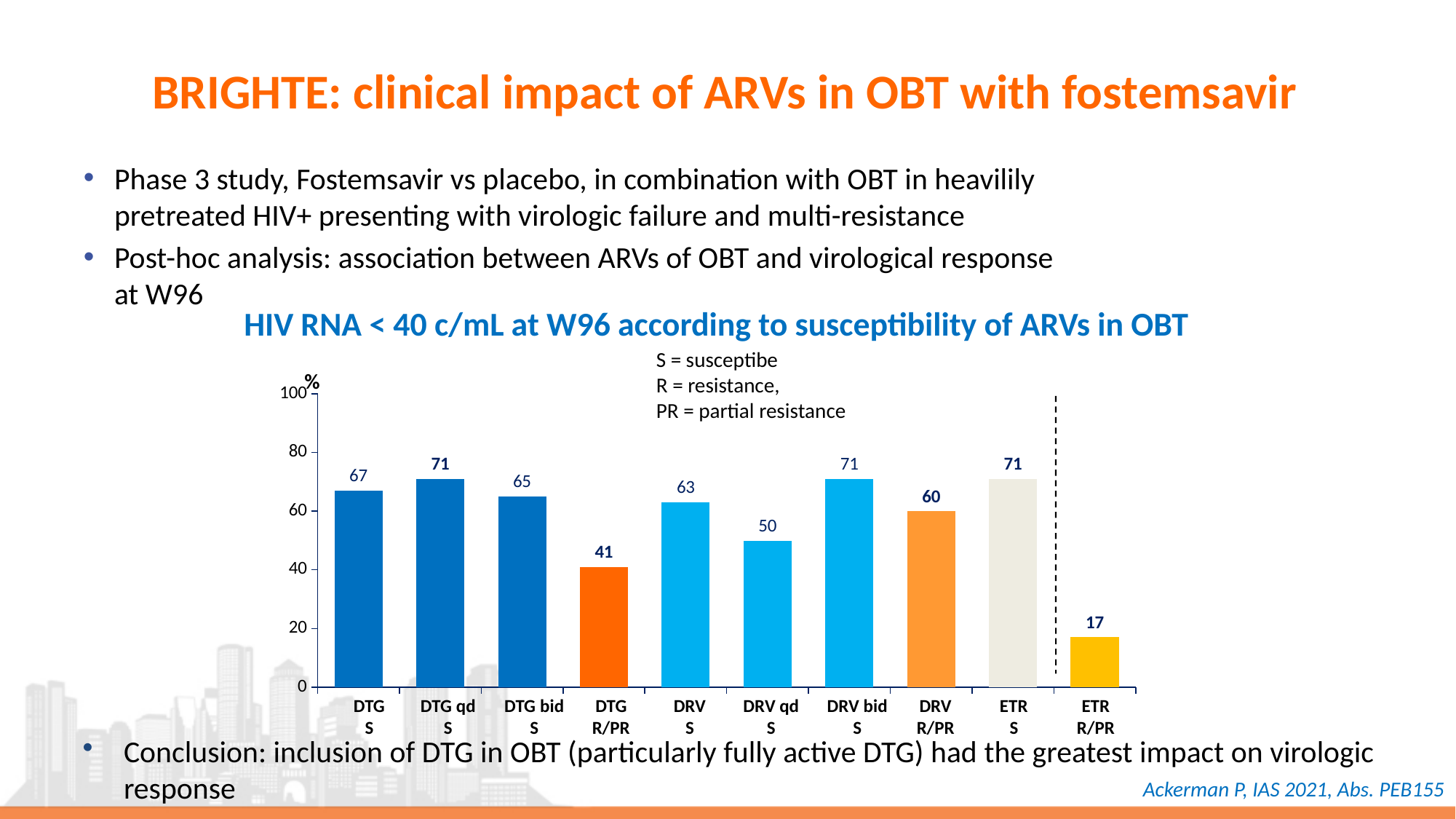
Which category has the lowest value? ETR R/PR What is the difference between the values for DTG qd S and DTG R/PR? 30 Which is larger, the value for DRV S or the value for DRV R/PR? DRV S What is the title of the chart? HIV RNA < 40 c/mL at W96 according to susceptibility of ARVs in OBT What is the value for ETR R/PR? 17 What kind of chart is shown on the slide? bar chart Is the value for DRV bid S greater or less than 60? greater What is the value for DTG S? 67 What is the difference between the values for ETR S and ETR R/PR? 54 What is the value for DTG R/PR? 41 What is the value for DRV qd S? 50 How many categories are shown on the x axis? 10